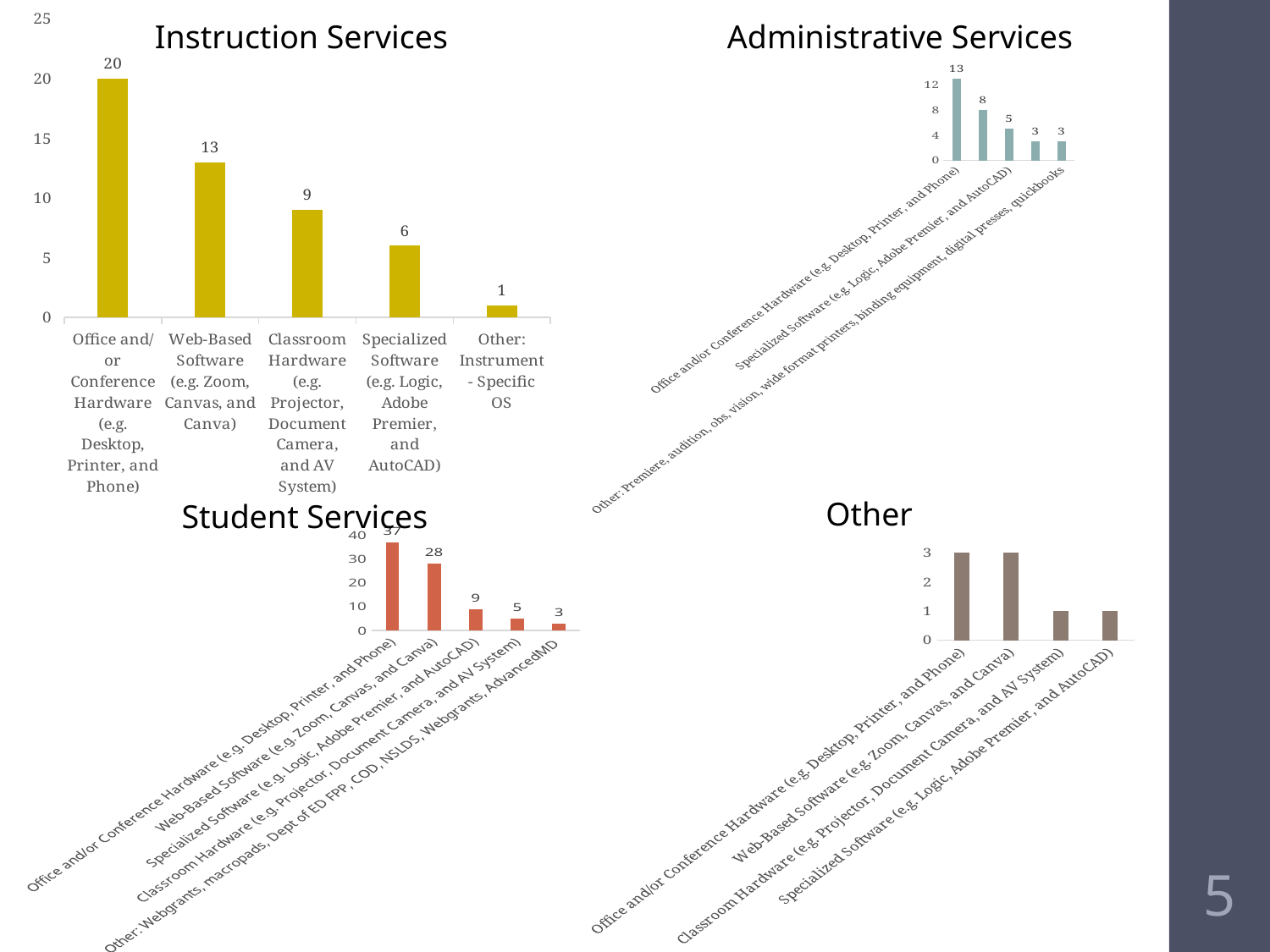
What type of chart is the Other chart? Bar chart In the Instruction Services chart, what is the difference between Office and/or Conference Hardware and Classroom Hardware? 11 How many categories are shown in the Instruction Services chart? 5 In the Student Services chart, which category has the highest value? Office and/or Conference Hardware In the Student Services chart, what is the value for Web-Based Software? 28 In the Instruction Services chart, which category has the lowest value? Other: Instrument-Specific OS In the Student Services chart, is the value for Office and/or Conference Hardware greater or less than 30? greater In the Administrative Services chart, what is the value for Office and/or Conference Hardware? 13 In the Other chart, which is larger: Web-Based Software or Classroom Hardware? Web-Based Software In the Instruction Services chart, which category has the highest value? Office and/or Conference Hardware In the Instruction Services chart, what is the value for Web-Based Software? 13 In the Administrative Services chart, what is the highest value shown? 13